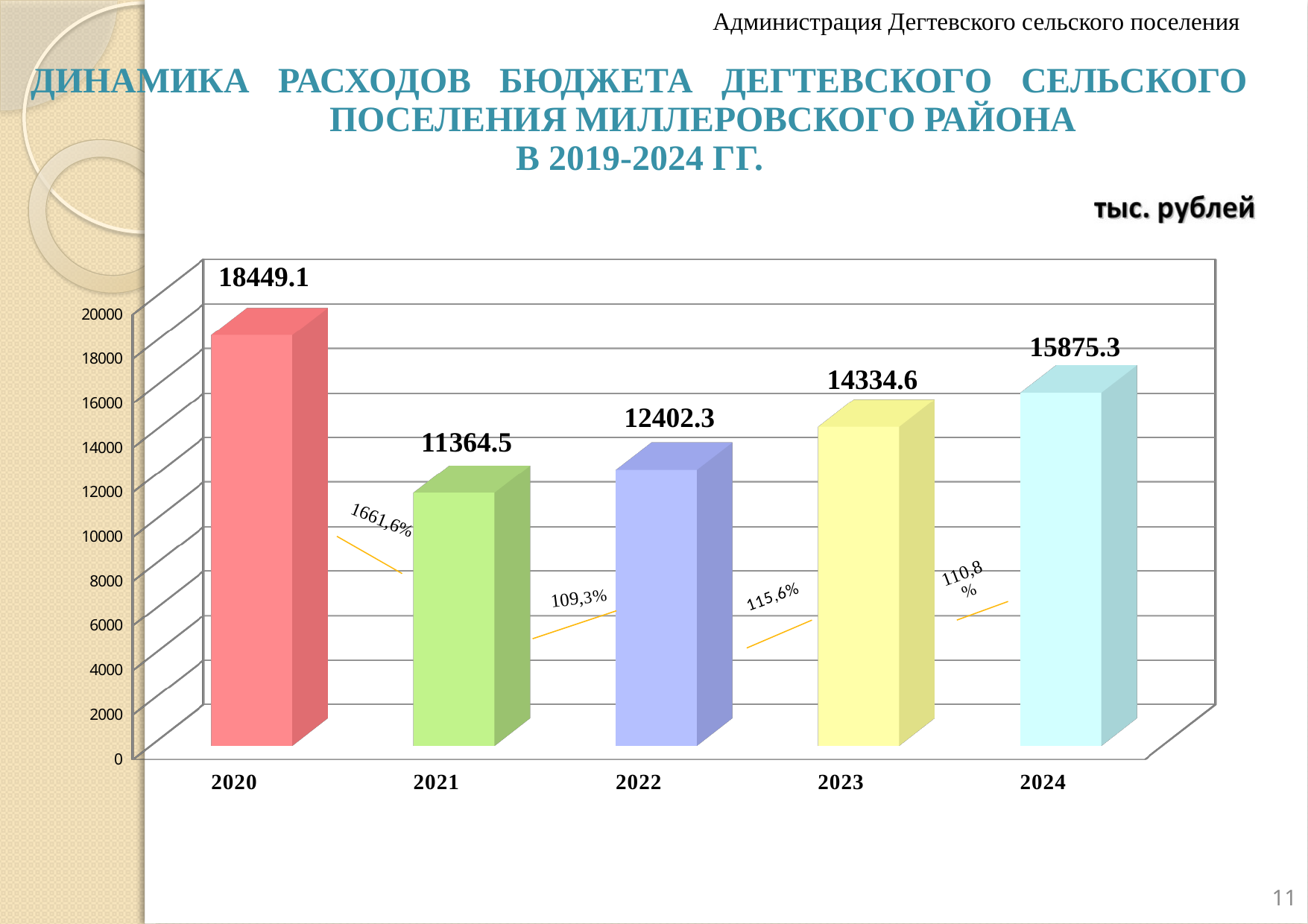
Do the values rise or fall from 2021 to 2024? rise Which year has the lowest value on the chart? 2021 What is the value shown for 2024? 15875.3 What is the difference between the values for 2020 and 2021? 7084.6 What is the budget expenditure value shown for 2020? 18449.1 How many years are shown on the x axis of the chart? 5 What kind of chart is shown on the slide? bar chart What is the difference between the values for 2024 and 2023? 1540.7 Which year has the highest value on the chart? 2020 Which is larger, the value for 2022 or the value for 2023? 2023 Is the value for 2021 greater or less than 12000? less What is the value shown for 2023? 14334.6